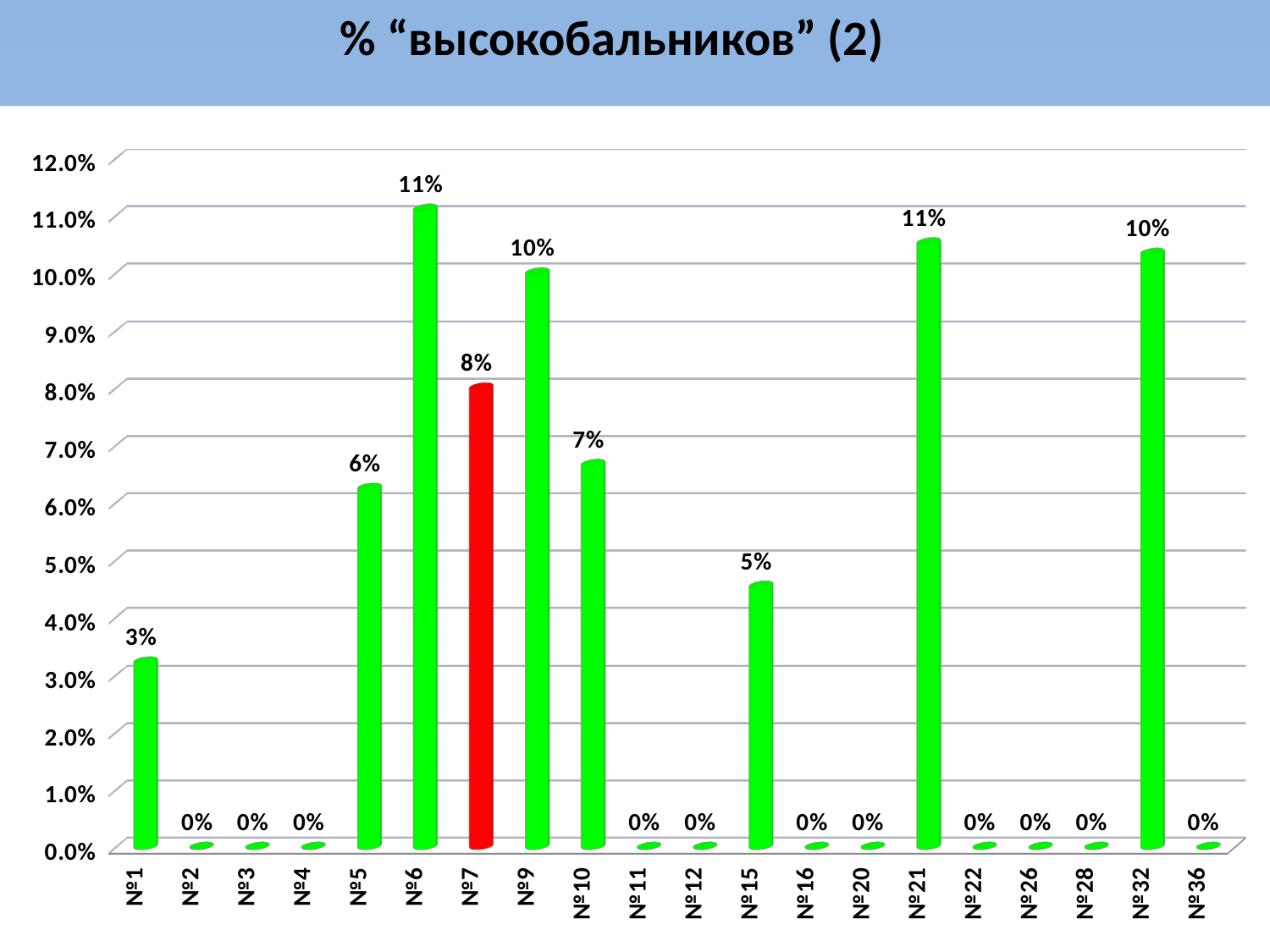
Is the value for №1 greater or less than 4.0%? less What is the difference between the values for №6 and №7? 3% What is the value for №15? 5% Is the value for №10 greater or less than 6.0%? greater What is the value for №7? 8% What is the value for №1? 3% Which is larger, the value for №5 or the value for №7? №7 Which category's bar is coloured red? №7 What is the value for №32? 10% Which is larger, the value for №9 or the value for №10? №9 What kind of chart is shown on the slide? Bar chart How many categories are shown on the x axis? 20